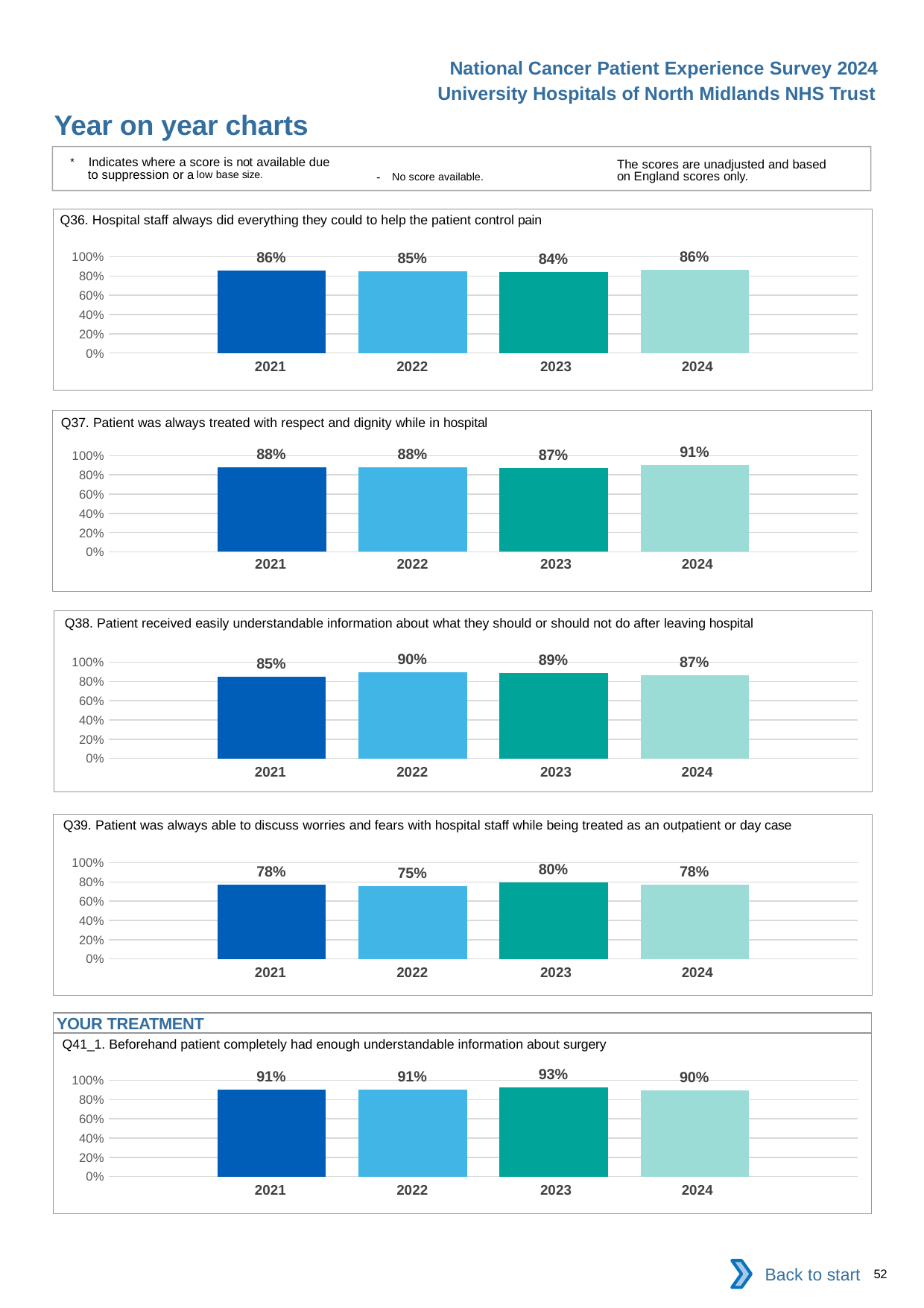
In the Q38 chart, which year has the lowest value? 2021 In the Q36 chart, what is the value for 2023? 84% In the Q41_1 chart, which is larger, the value for 2023 or the value for 2024? 2023 In the Q37 chart, which year has the highest value? 2024 In the Q39 chart, what is the difference between the 2023 value and the 2022 value? 5% In the Q39 chart, is the value for 2022 greater or less than 80%? less In the Q37 chart, does the value rise or fall from 2023 to 2024? rise What kind of chart is the Q37 chart? bar chart In the Q38 chart, what is the value for 2022? 90% What is the section heading shown above the Q41_1 chart? YOUR TREATMENT In the Q41_1 chart, what is the value for 2021? 91% How many years are shown in the Q36 chart? 4